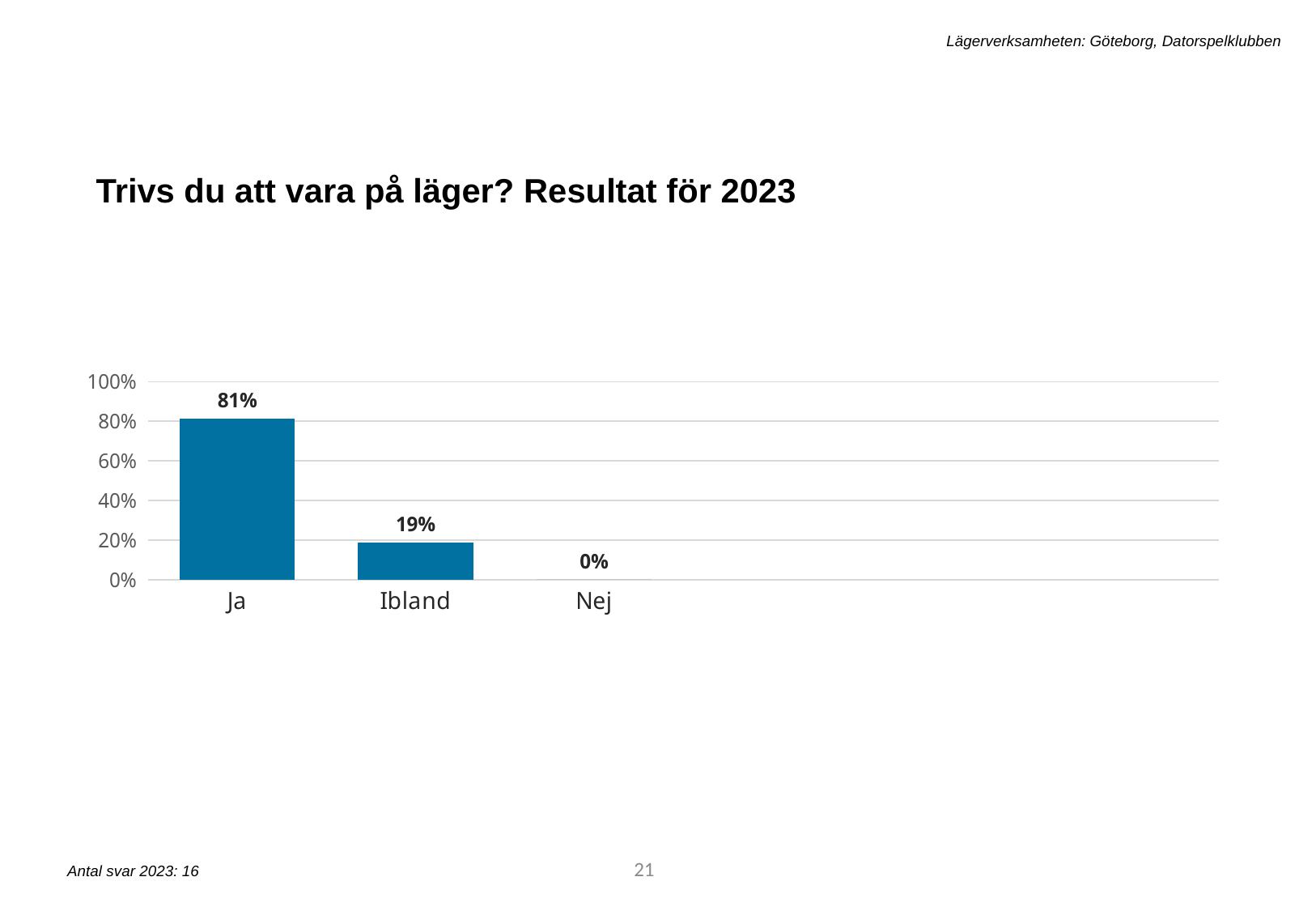
Which category has the lowest value? Nej Which is larger, the value for Ibland or the value for Nej? Ibland What is the value for Ja? 81% What is the title of the slide containing the chart? Trivs du att vara på läger? Resultat för 2023 Is the value for Ibland greater or less than 40%? less What is the value for Ibland? 19% Is the value for Ja greater or less than 60%? greater What is the value for Nej? 0% What is the difference between the values for Ja and Ibland? 62% What kind of chart is shown on the slide? bar chart How many categories are shown on the x axis? 3 Which category has the highest value? Ja